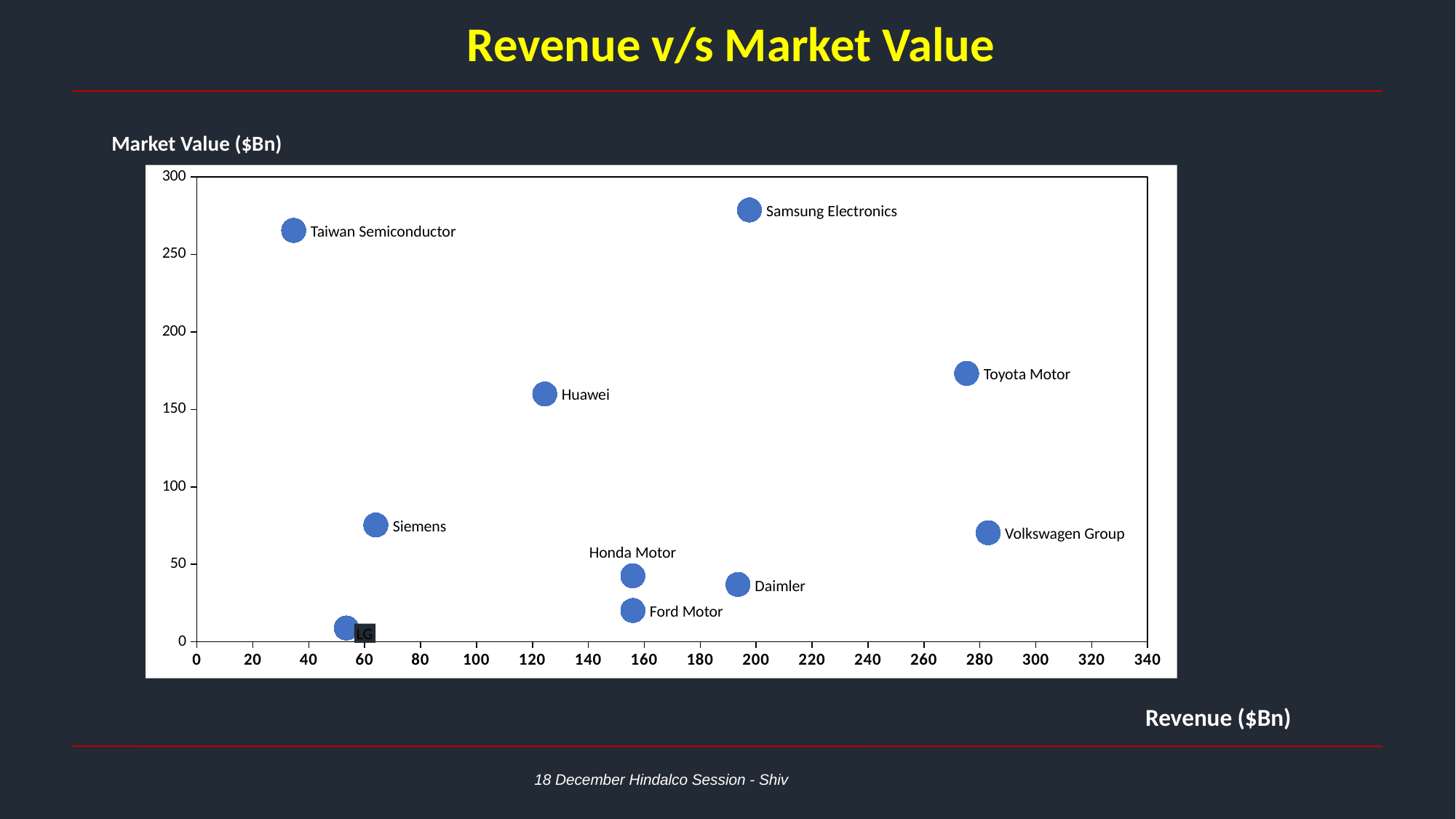
Is the market value for Huawei greater or less than 150? greater Which company has the lowest revenue on the chart? Taiwan Semiconductor Which has the higher market value, Toyota Motor or Huawei? Toyota Motor Which company has the highest market value on the chart? Samsung Electronics Which has the higher market value, Honda Motor or Ford Motor? Honda Motor Is the revenue for Honda Motor greater or less than 140? greater Is the revenue for Volkswagen Group greater or less than 260? greater How many companies are plotted on the chart? 10 What kind of chart is shown on the slide? Scatter chart What is the label of the vertical axis? Market Value ($Bn) Which company has the lowest market value on the chart? LG